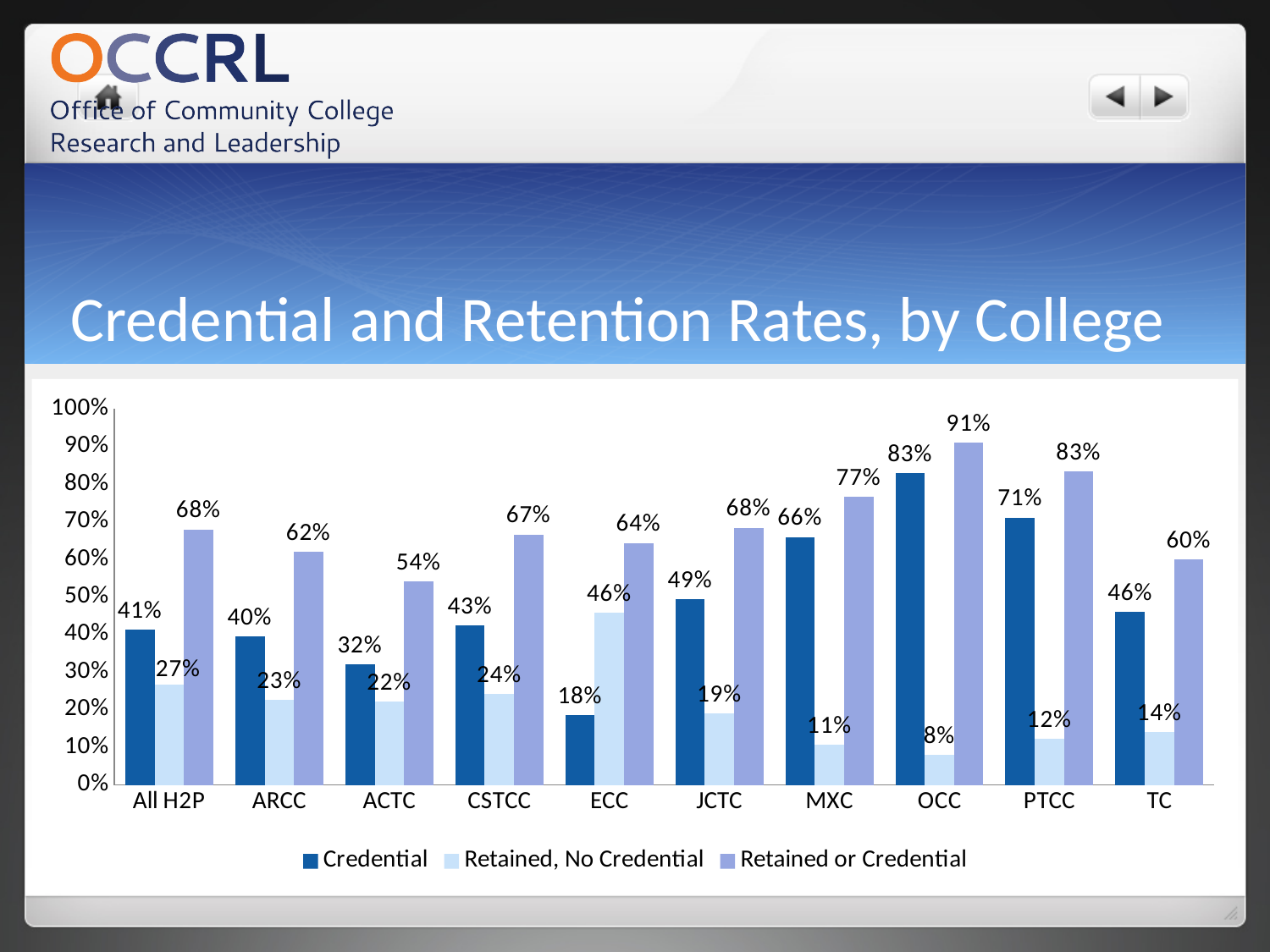
What is the difference between the Retained or Credential rate and the Credential rate for PTCC? 12% How many series does the legend list? 3 What is the title of the chart? Credential and Retention Rates, by College What is the Retained, No Credential rate for ECC? 46% What is the Retained or Credential rate for ACTC? 54% Which college has the lowest Credential rate? ECC How many colleges (categories) are shown on the x axis? 10 What is the Retained, No Credential rate for OCC? 8% Which college has the highest Retained or Credential rate? OCC What is the Credential rate for OCC? 83% Which is larger for JCTC: the Credential rate or the Retained, No Credential rate? Credential What kind of chart is shown on the slide? Bar chart